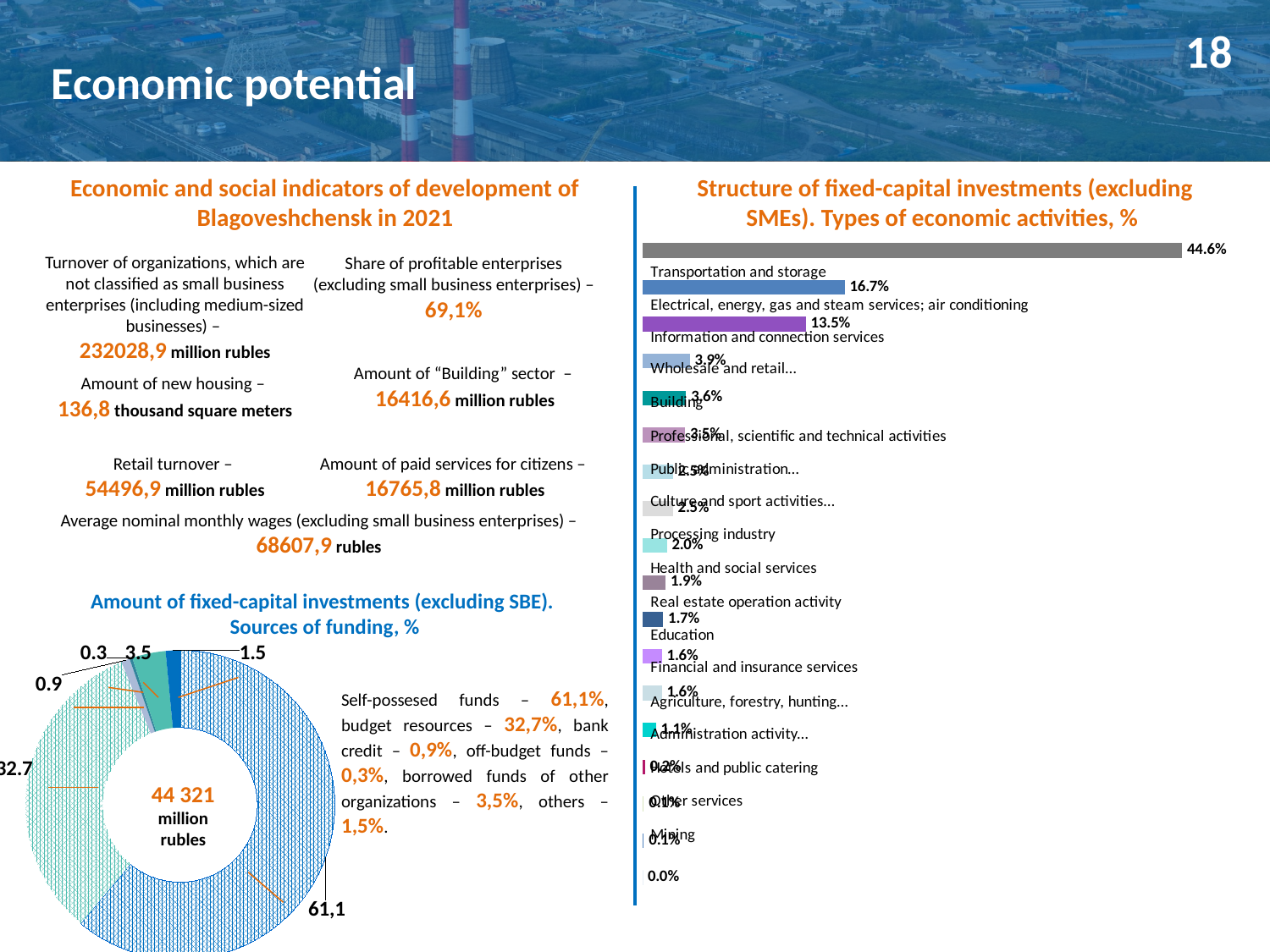
In the 'Structure of fixed-capital investments' bar chart, what value is shown for Mining? 0.0% What kind of chart is the 'Amount of fixed-capital investments (excluding SBE). Sources of funding, %' chart? Doughnut (pie) chart What kind of chart is the 'Structure of fixed-capital investments (excluding SMEs)' chart? Bar chart In the 'Structure of fixed-capital investments' bar chart, what value is shown for Information and connection services? 13.5% In the 'Structure of fixed-capital investments' bar chart, what is the highest value shown? 44.6% In the 'Structure of fixed-capital investments' bar chart, what is the difference between the values for Transportation and storage and Electrical, energy, gas and steam services? 27.9% In the 'Structure of fixed-capital investments' bar chart, what value is shown for Transportation and storage? 44.6% In the 'Sources of funding' doughnut chart, what is the value of the largest slice? 61,1 In the 'Structure of fixed-capital investments' bar chart, which is larger: the value for Information and connection services or the value for Wholesale and retail? Information and connection services What total amount is printed in the centre of the 'Sources of funding' doughnut chart? 44 321 million rubles How many categories are shown in the 'Structure of fixed-capital investments' bar chart? 18 In the 'Structure of fixed-capital investments' bar chart, what value is shown for Electrical, energy, gas and steam services; air conditioning? 16.7%